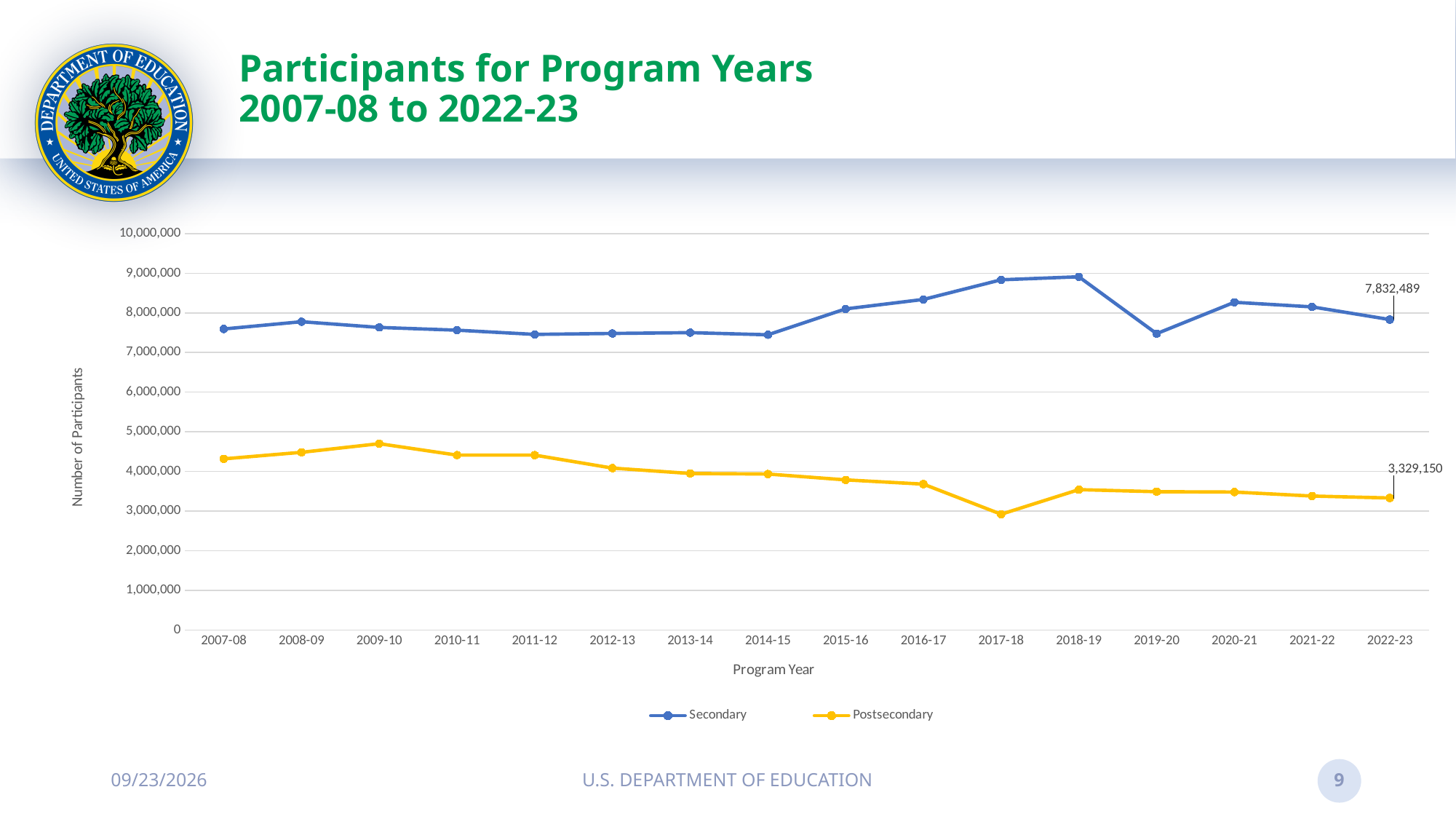
Which program year has the highest Postsecondary value? 2009-10 Which program year has the lowest Postsecondary value? 2017-18 What is the value for Postsecondary in 2022-23? 3,329,150 Which is larger, the Secondary value in 2018-19 or the Secondary value in 2019-20? 2018-19 What is the value for Secondary in 2022-23? 7,832,489 Which program year has the highest Secondary value? 2018-19 What is the difference between the Secondary and Postsecondary values in 2022-23? 4,503,339 Is the Secondary value for 2017-18 greater or less than 8,000,000? greater How many series does the legend list? 2 What kind of chart is shown on the slide? line chart How many program years are shown on the x axis? 16